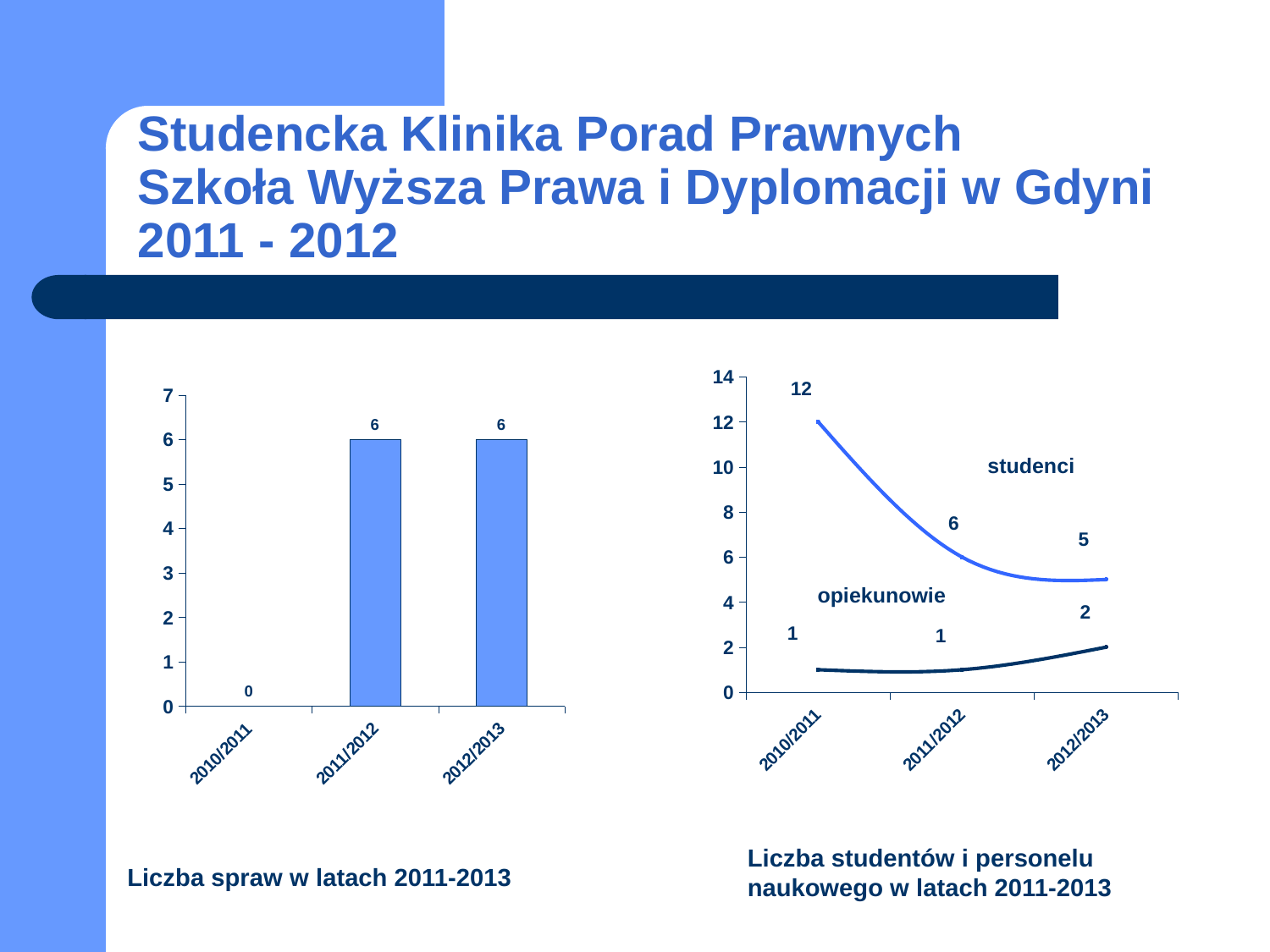
In the right chart (Liczba studentów i personelu naukowego), does the studenci series rise or fall from 2010/2011 to 2012/2013? fall In the right chart (Liczba studentów i personelu naukowego), what is the value for opiekunowie in 2012/2013? 2 How many series are plotted in the right chart (Liczba studentów i personelu naukowego)? 2 In the right chart (Liczba studentów i personelu naukowego), what is the difference between studenci and opiekunowie in 2011/2012? 5 In the left chart (Liczba spraw w latach 2011-2013), what is the value for 2011/2012? 6 In the right chart (Liczba studentów i personelu naukowego), which series has the higher value in 2012/2013, studenci or opiekunowie? studenci In the left chart (Liczba spraw w latach 2011-2013), what is the value for 2010/2011? 0 What kind of chart is the left chart (Liczba spraw w latach 2011-2013)? bar chart In the right chart (Liczba studentów i personelu naukowego), what is the value for studenci in 2010/2011? 12 What kind of chart is the right chart (Liczba studentów i personelu naukowego)? line chart How many categories are shown on the x axis of the left chart (Liczba spraw w latach 2011-2013)? 3 In the left chart (Liczba spraw w latach 2011-2013), which category has the lowest value? 2010/2011